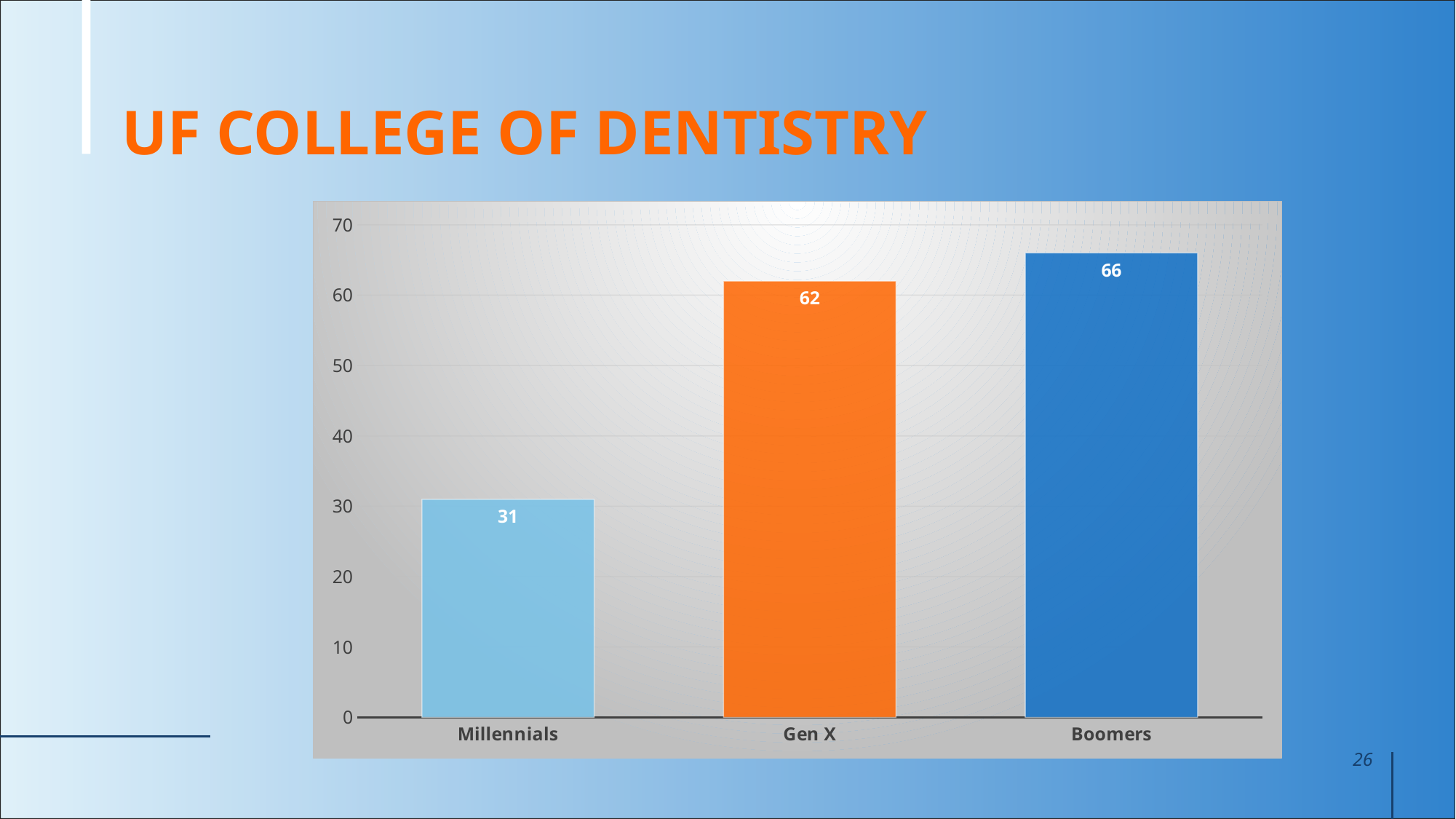
What is the value for Gen X? 62 What is the difference between the values for Gen X and Millennials? 31 How many categories are shown on the x axis? 3 Do the values rise or fall from Millennials to Boomers along the x axis? rise What is the value for Boomers? 66 Which is larger, the value for Gen X or the value for Millennials? Gen X Is the value for Millennials greater or less than 40? less Which category has the lowest value? Millennials What is the value for Millennials? 31 What kind of chart is shown on the slide? bar chart What is the difference between the values for Boomers and Millennials? 35 Which category has the highest value? Boomers